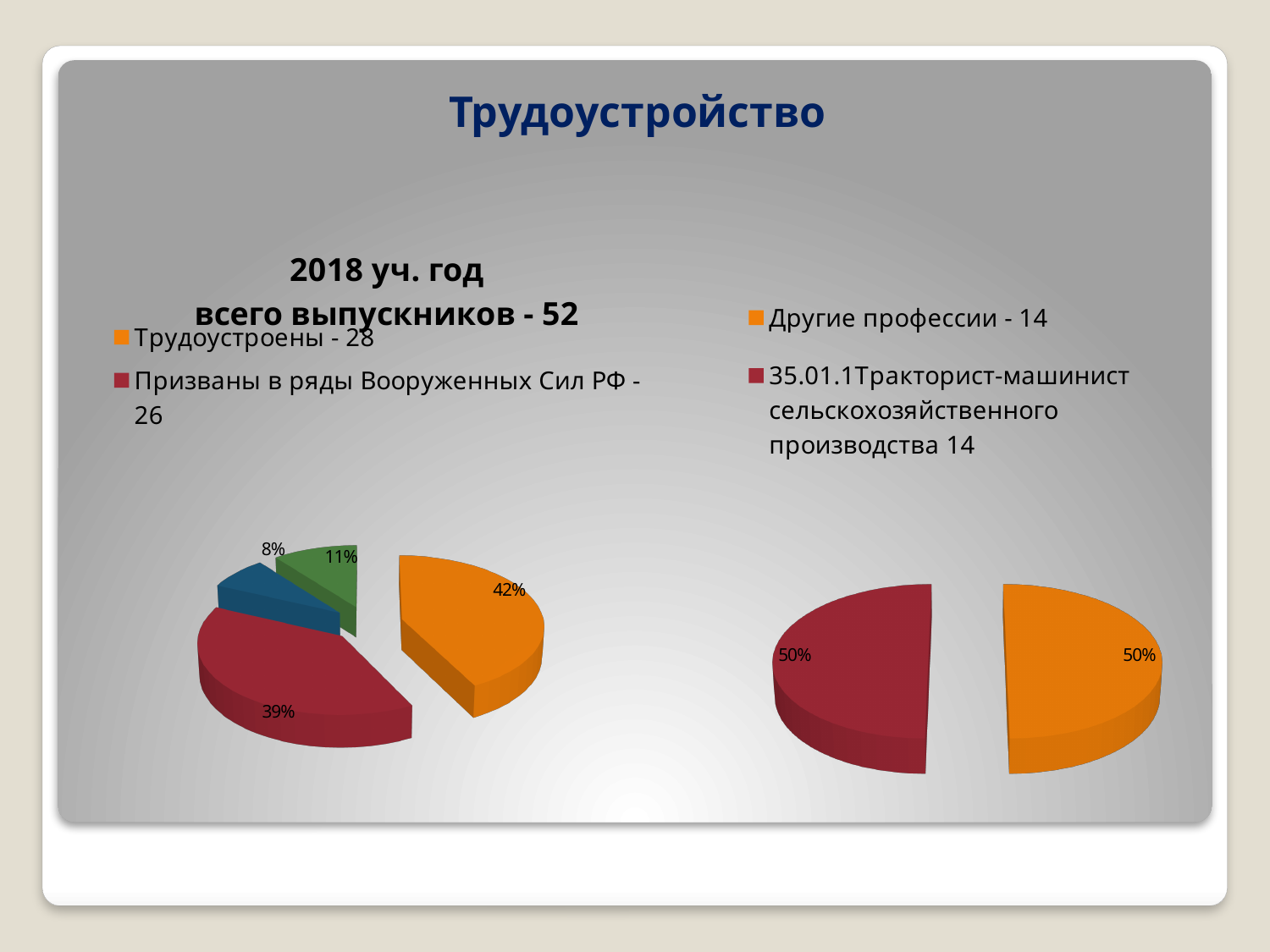
In the right chart, what percentage share does the "Другие профессии - 14" slice have? 50% What is the total number of graduates stated in the title of the left chart? 52 What type of chart is the left chart titled "2018 уч. год всего выпускников - 52"? Pie chart How many slices does the left pie chart (2018 уч. год) have? 4 In the left chart (2018 уч. год), which legend category has the largest slice? Трудоустроены - 28 In the left chart (2018 уч. год), which is larger: the "Трудоустроены" slice or the "Призваны в ряды Вооруженных Сил РФ" slice? Трудоустроены How many entries does the legend of the right chart list? 2 In the left chart (2018 уч. год), by how many percentage points does the "Трудоустроены" slice exceed the "Призваны в ряды Вооруженных Сил РФ" slice? 3 percentage points In the left chart (2018 уч. год), what is the percentage of the smallest slice? 8% In the left chart (2018 уч. год), what percentage share does the "Трудоустроены - 28" slice have? 42% In the right chart, what percentage share does the "35.01.1Тракторист-машинист сельскохозяйственного производства 14" slice have? 50%